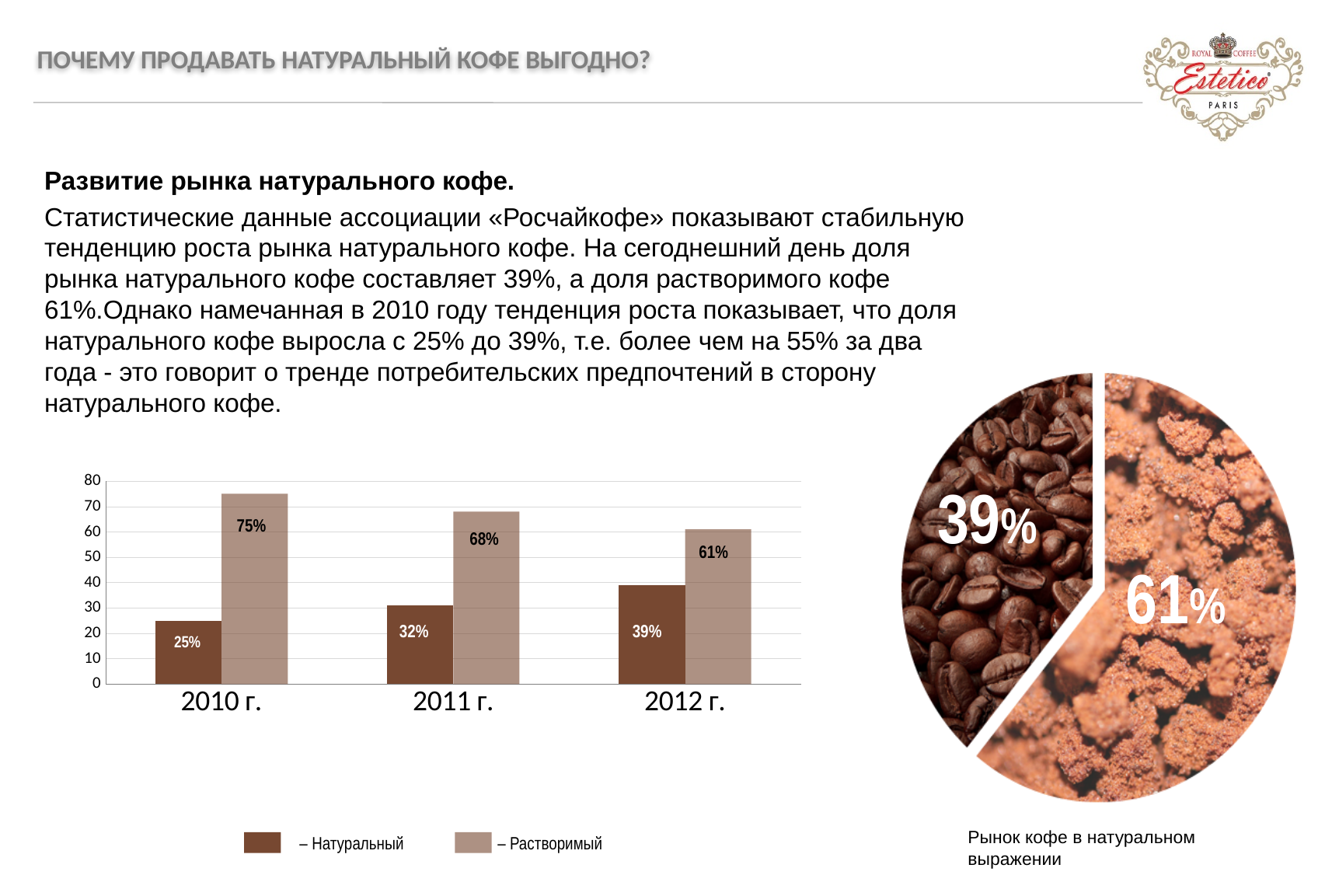
In the pie chart on the right, what share is shown for the larger slice? 61% In the bar chart on the left, what is the difference between Растворимый and Натуральный in 2012 г.? 22% In the bar chart on the left, which year has the highest value for Растворимый? 2010 г. What kind of chart is shown on the right side of the slide? pie chart In the bar chart on the left, does the value for Натуральный rise or fall from 2010 г. to 2012 г.? rise In the bar chart on the left, how many years are shown on the x axis? 3 In the bar chart on the left, which year has the lowest value for Натуральный? 2010 г. In the bar chart on the left, what is the value for Натуральный in 2010 г.? 25% In the bar chart on the left, what is the value for Натуральный in 2012 г.? 39% In the bar chart on the left, what is the value for Растворимый in 2011 г.? 68% In the bar chart on the left, how many series does the legend list? 2 In the bar chart on the left, which is larger in 2011 г.: Натуральный or Растворимый? Растворимый